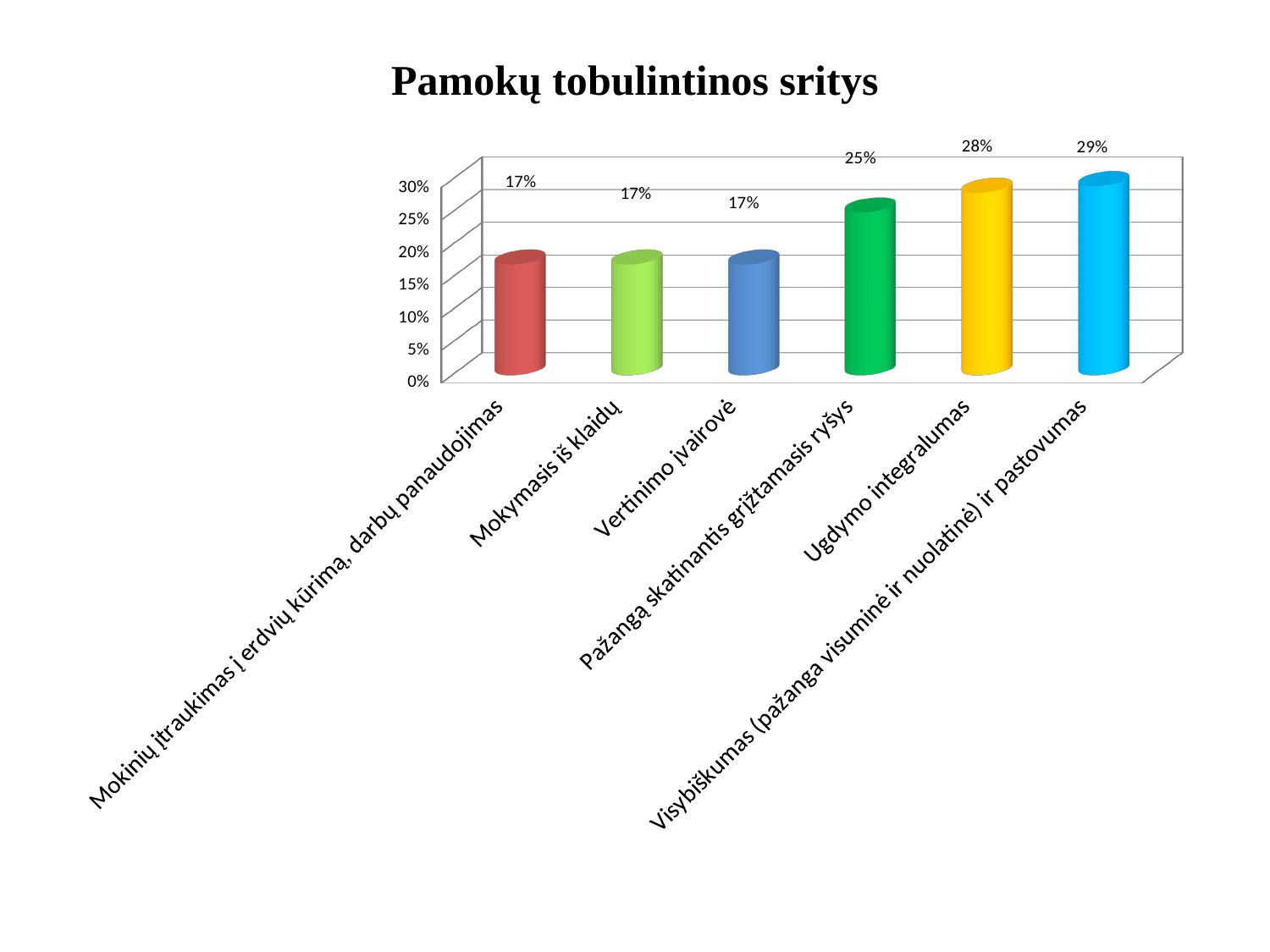
What is the value for Ugdymo integralumas? 28% What kind of chart is shown on the slide? bar chart Is the value for Pažangą skatinantis grįžtamasis ryšys greater or less than 20%? greater How many categories are shown in the chart? 6 Which is larger, the value for Ugdymo integralumas or the value for Vertinimo įvairovė? Ugdymo integralumas Which category has the highest value? Visybiškumas (pažanga visuminė ir nuolatinė) ir pastovumas How many categories have a value of 17%? 3 What is the value for Pažangą skatinantis grįžtamasis ryšys? 25% What is the difference between the values for Ugdymo integralumas and Pažangą skatinantis grįžtamasis ryšys? 3% What is the value for Vertinimo įvairovė? 17% What is the difference between the values for Visybiškumas (pažanga visuminė ir nuolatinė) ir pastovumas and Mokymasis iš klaidų? 12% What is the title of the chart? Pamokų tobulintinos sritys